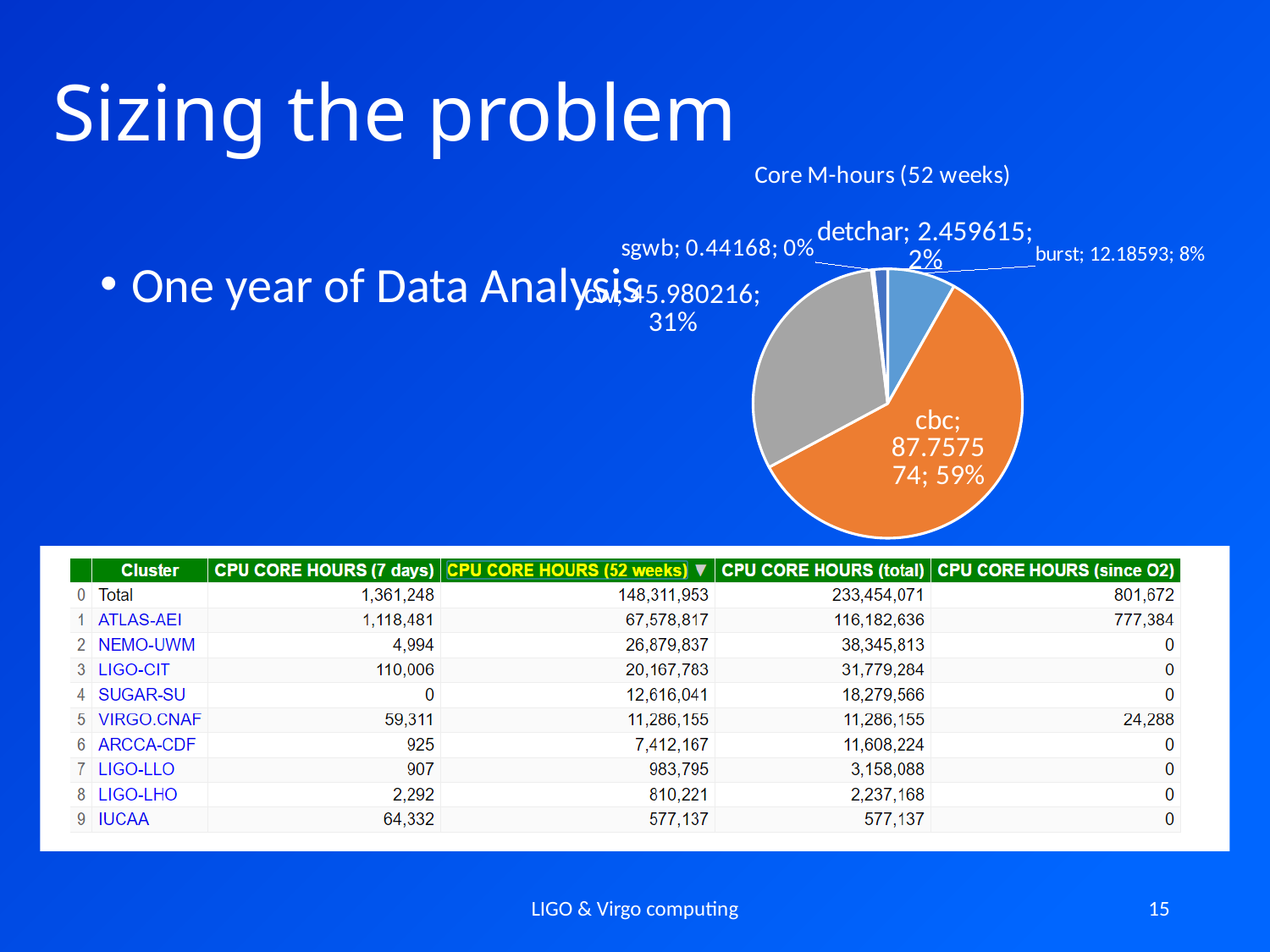
What is the title of the pie chart? Core M-hours (52 weeks) What share of the pie does the detchar slice represent? 2% What share of the pie does the burst slice represent? 8% Which is larger in the pie chart, burst or detchar? burst How many slices does the pie chart have? 5 What value is shown for the cbc slice of the pie chart? 87.757574 What value is shown for the burst slice of the pie chart? 12.18593 What kind of chart is shown on the slide? pie chart Which slice of the pie chart is the smallest? sgwb Which slice of the pie chart is the largest? cbc What share of the pie does the cbc slice represent? 59% What value is shown for the detchar slice of the pie chart? 2.459615